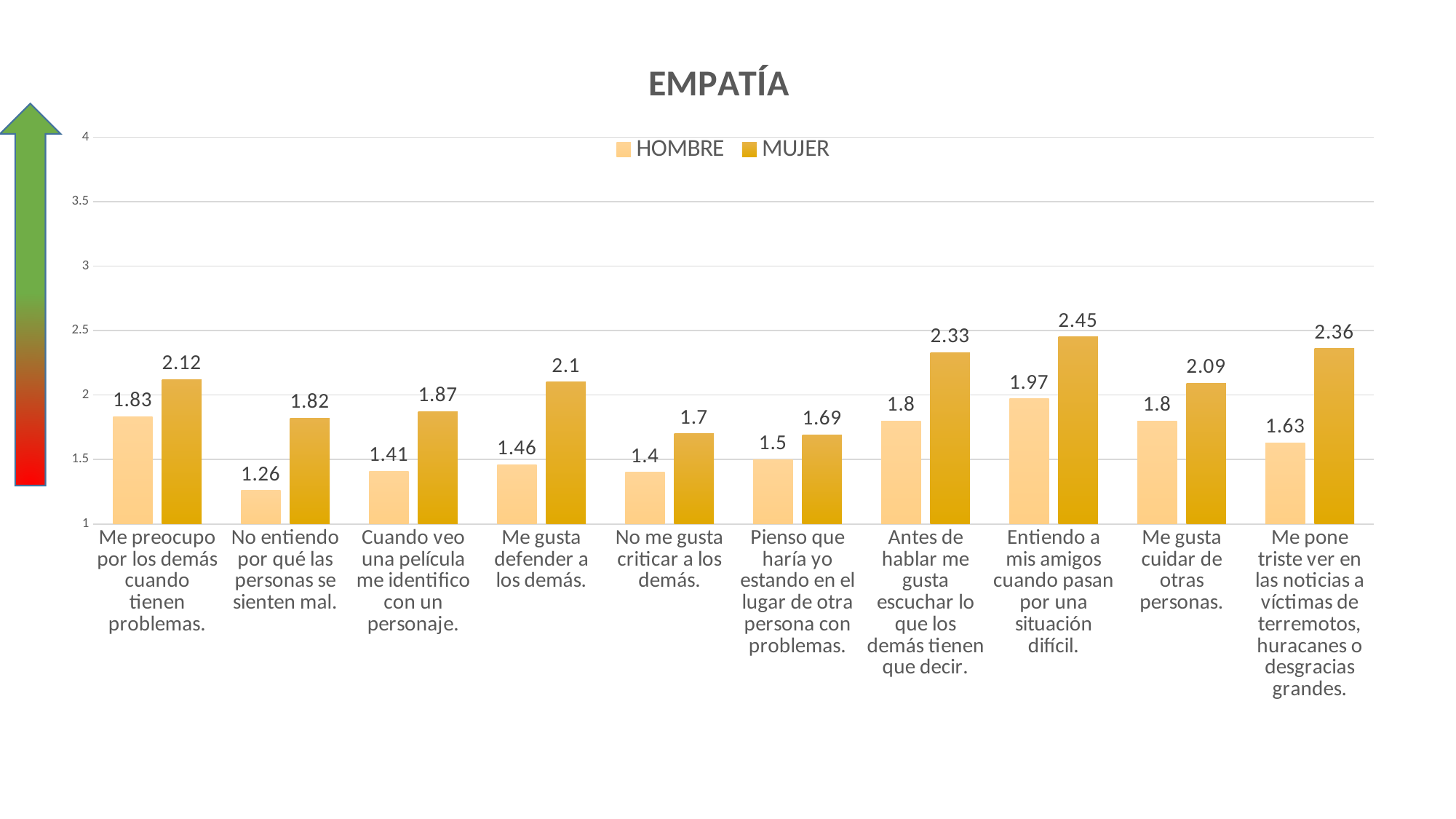
What is the HOMBRE value for "Me preocupo por los demás cuando tienen problemas."? 1.83 Is the MUJER value for "Antes de hablar me gusta escuchar lo que los demás tienen que decir." greater or less than 2? greater Which category has the lowest HOMBRE value? No entiendo por qué las personas se sienten mal. How many series does the legend list? 2 What is the difference between the MUJER and HOMBRE values for "Me gusta defender a los demás."? 0.64 Which category has the highest MUJER value? Entiendo a mis amigos cuando pasan por una situación difícil. What is the title of the chart? EMPATÍA Which category has the lowest MUJER value? Pienso que haría yo estando en el lugar de otra persona con problemas. What kind of chart is shown on the slide? Bar chart How many categories are shown on the x axis? 10 What is the MUJER value for "Me pone triste ver en las noticias a víctimas de terremotos, huracanes o desgracias grandes."? 2.36 For "Me gusta cuidar de otras personas.", which series has the larger value, HOMBRE or MUJER? MUJER